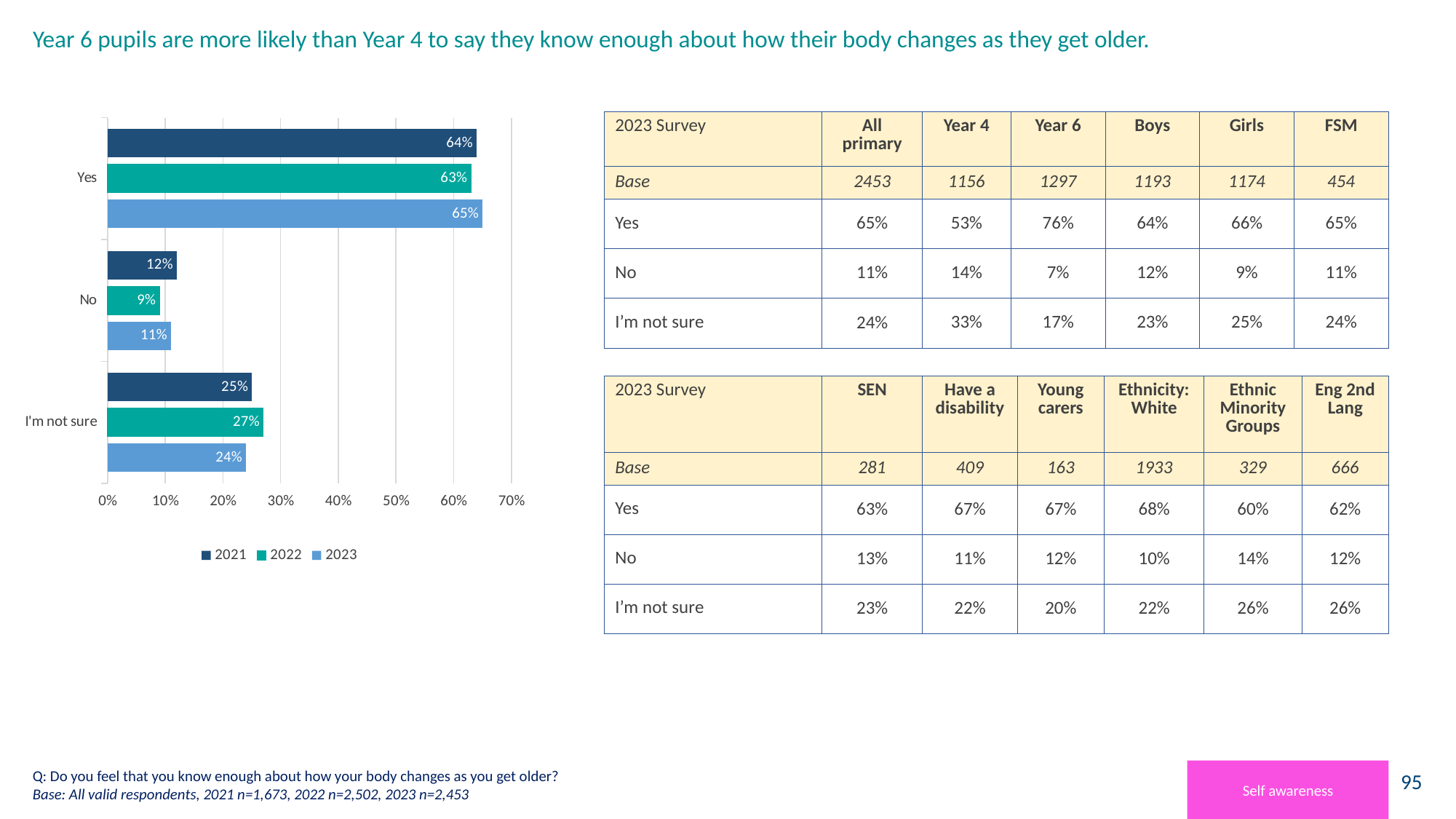
Which year has the lowest value for 'No'? 2022 What is the value for 'Yes' in 2023? 65% Which series is shown in the darkest blue colour in the legend? 2021 What is the difference between the 'Yes' value in 2023 and the 'Yes' value in 2022? 2% Which is larger: the 'No' value in 2021 or the 'No' value in 2023? 2021 How many series does the chart legend list? 3 Is the value for 'Yes' in 2021 greater or less than 60%? greater Which year has the highest value for 'I'm not sure'? 2022 What is the value for 'No' in 2022? 9% What is the value for 'I'm not sure' in 2021? 25% What kind of chart is shown on the slide? bar chart How many response categories are shown on the chart? 3